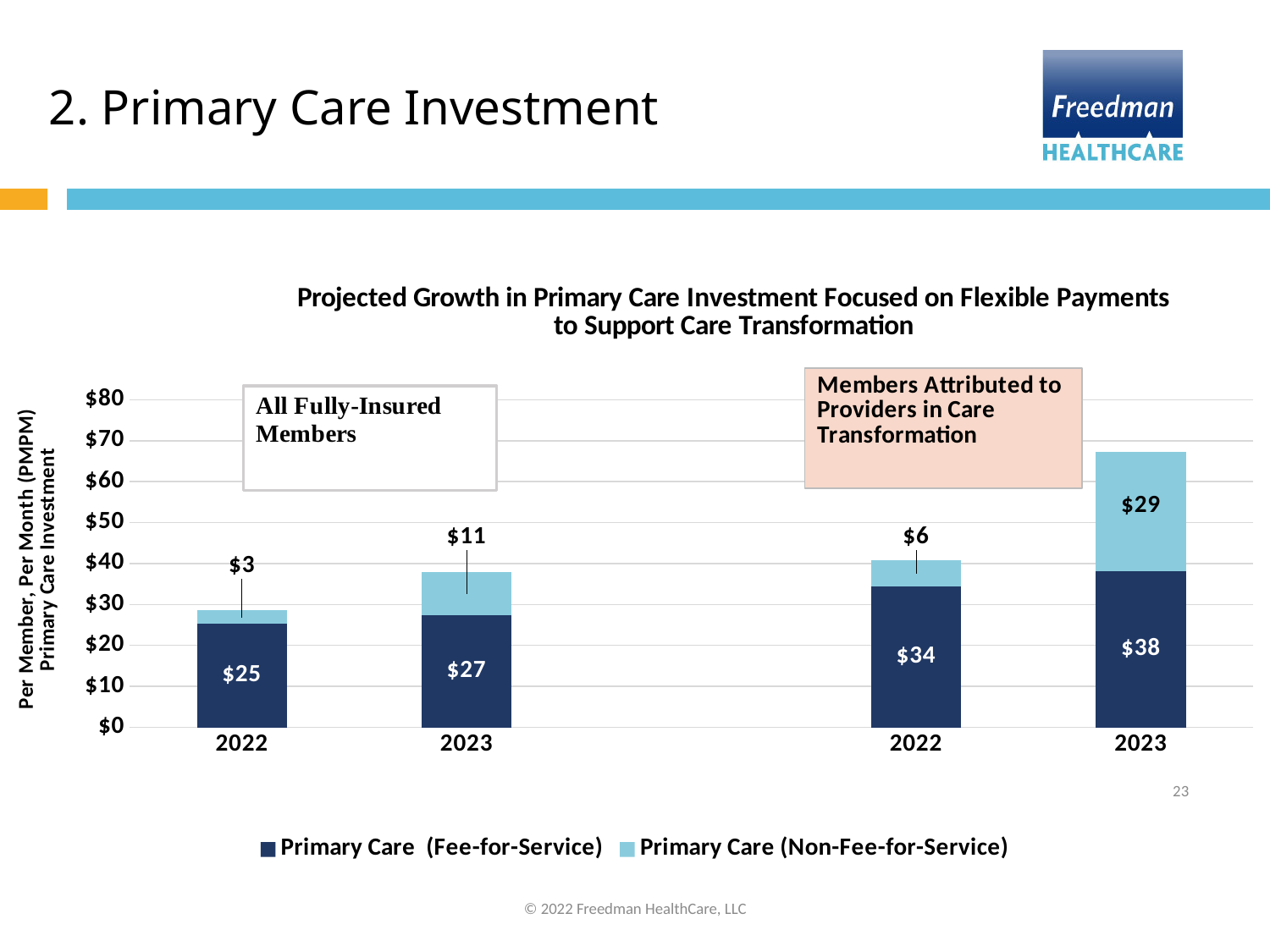
What is the difference between the Primary Care (Non-Fee-for-Service) values for 2023 and 2022 among Members Attributed to Providers in Care Transformation? $23 How many series does the legend list? 2 What is the Primary Care (Fee-for-Service) value for 2023 among Members Attributed to Providers in Care Transformation? $38 What is the Primary Care (Non-Fee-for-Service) value for 2023 among Members Attributed to Providers in Care Transformation? $29 Which bar has the highest Primary Care (Non-Fee-for-Service) value? 2023, Members Attributed to Providers in Care Transformation What is the total of the stacked bar for 2023 among Members Attributed to Providers in Care Transformation? $67 What is the Primary Care (Fee-for-Service) value for 2022 among All Fully-Insured Members? $25 What kind of chart is shown on the slide? Stacked bar chart Is the Primary Care (Fee-for-Service) value for 2022 among Members Attributed to Providers in Care Transformation larger or smaller than the Fee-for-Service value for 2023 among All Fully-Insured Members? larger What is the total of the stacked bar for 2023 among All Fully-Insured Members? $38 What is the Primary Care (Non-Fee-for-Service) value for 2022 among All Fully-Insured Members? $3 Which bar has the lowest Primary Care (Fee-for-Service) value? 2022, All Fully-Insured Members